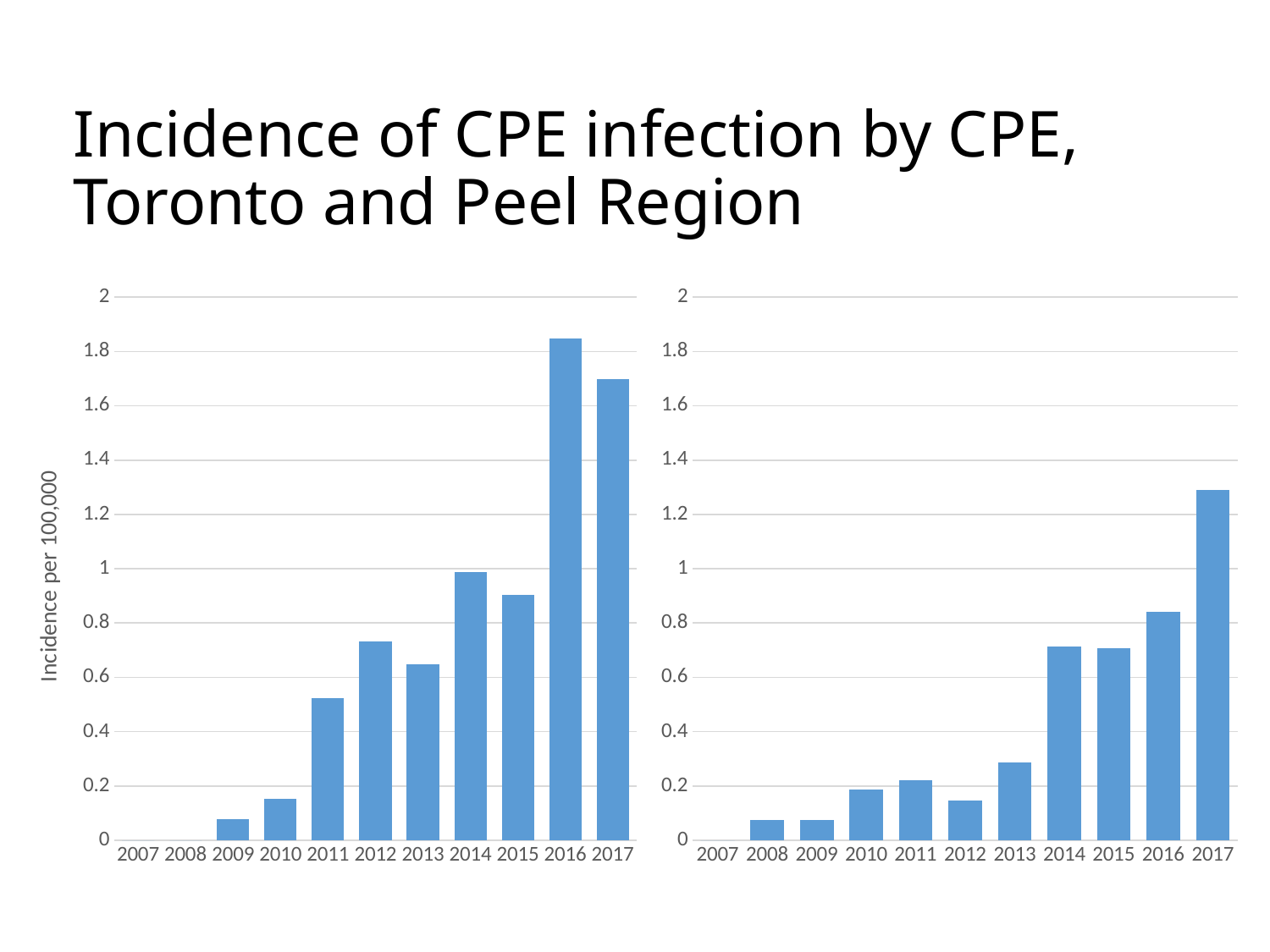
In the right chart, is the value for 2013 greater or less than 0.4? less How many years are shown on the x axis of the right chart? 11 What is the y-axis label of the left chart? Incidence per 100,000 In the left chart, which year has the highest incidence? 2016 In the left chart, which is larger, the value for 2012 or the value for 2013? 2012 In the left chart, is the value for 2016 greater or less than 1.8? greater In the right chart, which year has the highest incidence? 2017 In the right chart, does the incidence generally rise or fall from 2008 to 2017? rise What kind of chart is the left chart on the slide? bar chart In the right chart, which is larger, the value for 2016 or the value for 2017? 2017 In the right chart, is the value for 2017 greater or less than 1.2? greater